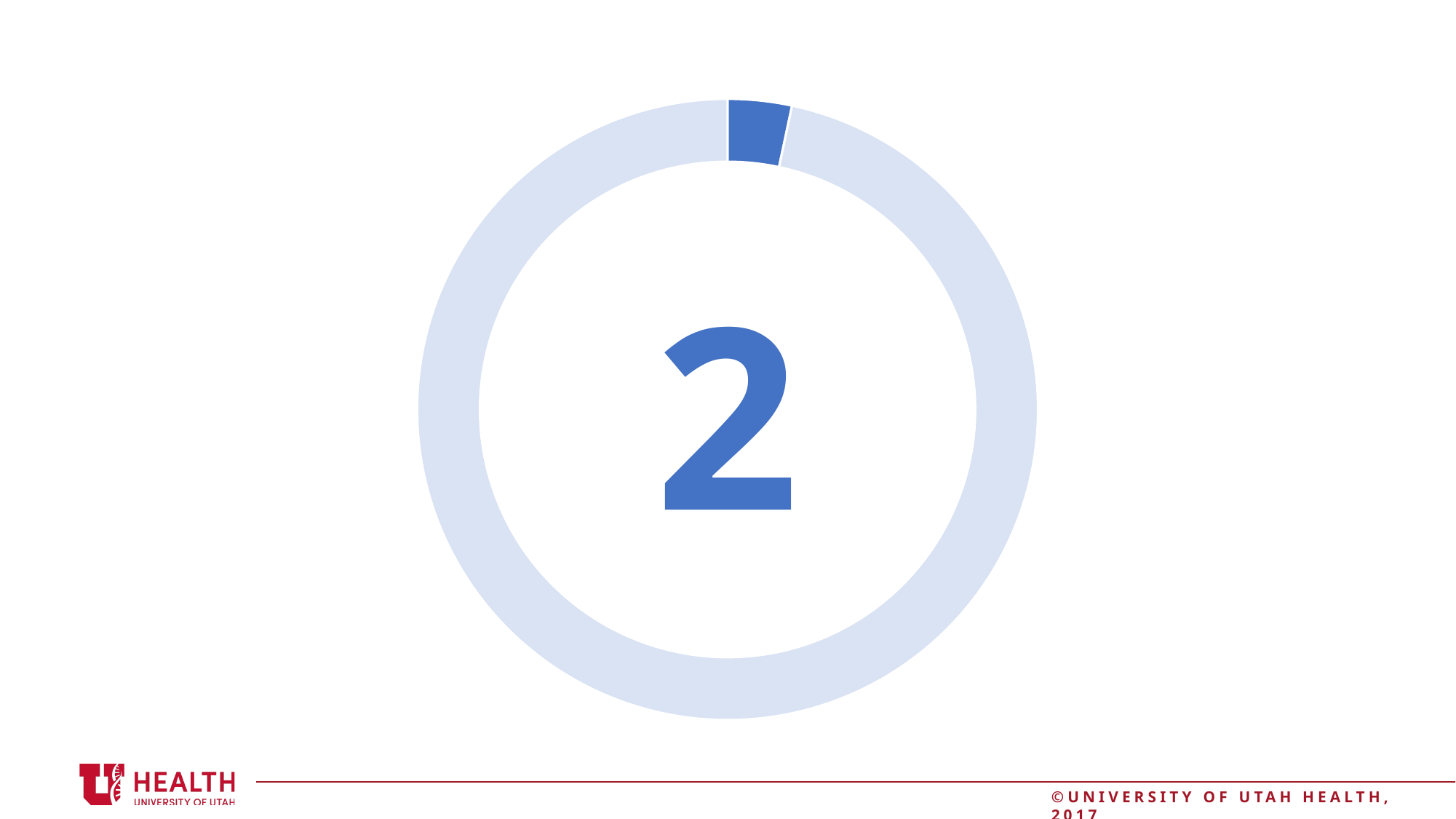
What number is printed in the centre of the doughnut chart? 2 Does the doughnut chart have a legend? No Which segment of the doughnut chart is larger, the dark blue one or the light blue one? the light blue one What kind of chart is shown on the slide? doughnut chart How many segments does the doughnut chart have? 2